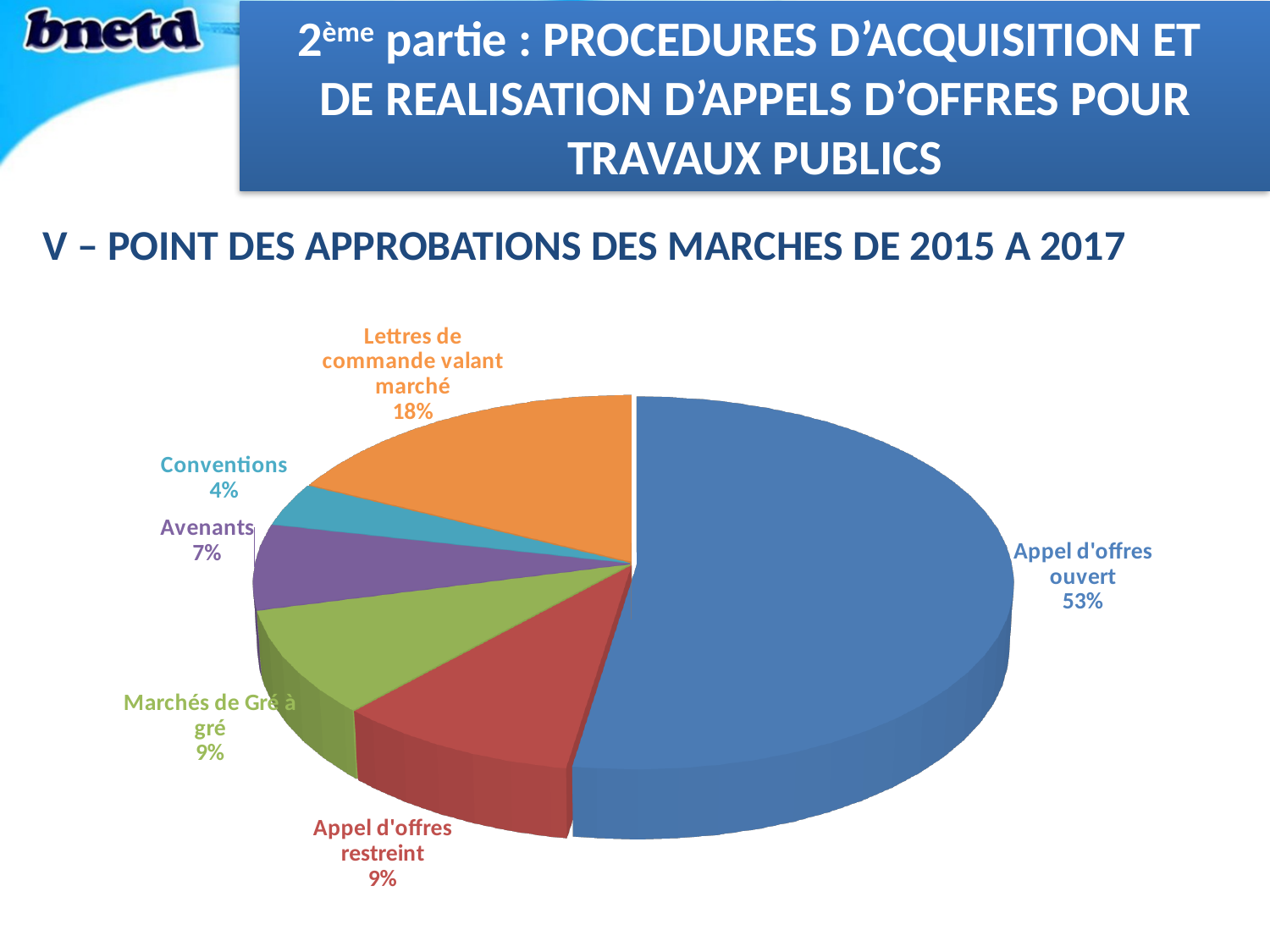
Which is larger, the share for "Avenants" or the share for "Conventions"? Avenants What is the value shown for "Avenants"? 7% What is the difference between the shares of "Appel d'offres ouvert" and "Lettres de commande valant marché"? 35% What kind of chart is shown on the slide? Pie chart What colour is the slice for "Appel d'offres restreint"? Red What is the value shown for "Marchés de Gré à gré"? 9% What share of the pie does "Appel d'offres ouvert" represent? 53% Which category has the smallest slice of the pie? Conventions How many categories are shown in the pie chart? 6 What is the value shown for "Conventions"? 4% What share of the pie does "Lettres de commande valant marché" represent? 18% Which category has the largest slice of the pie? Appel d'offres ouvert